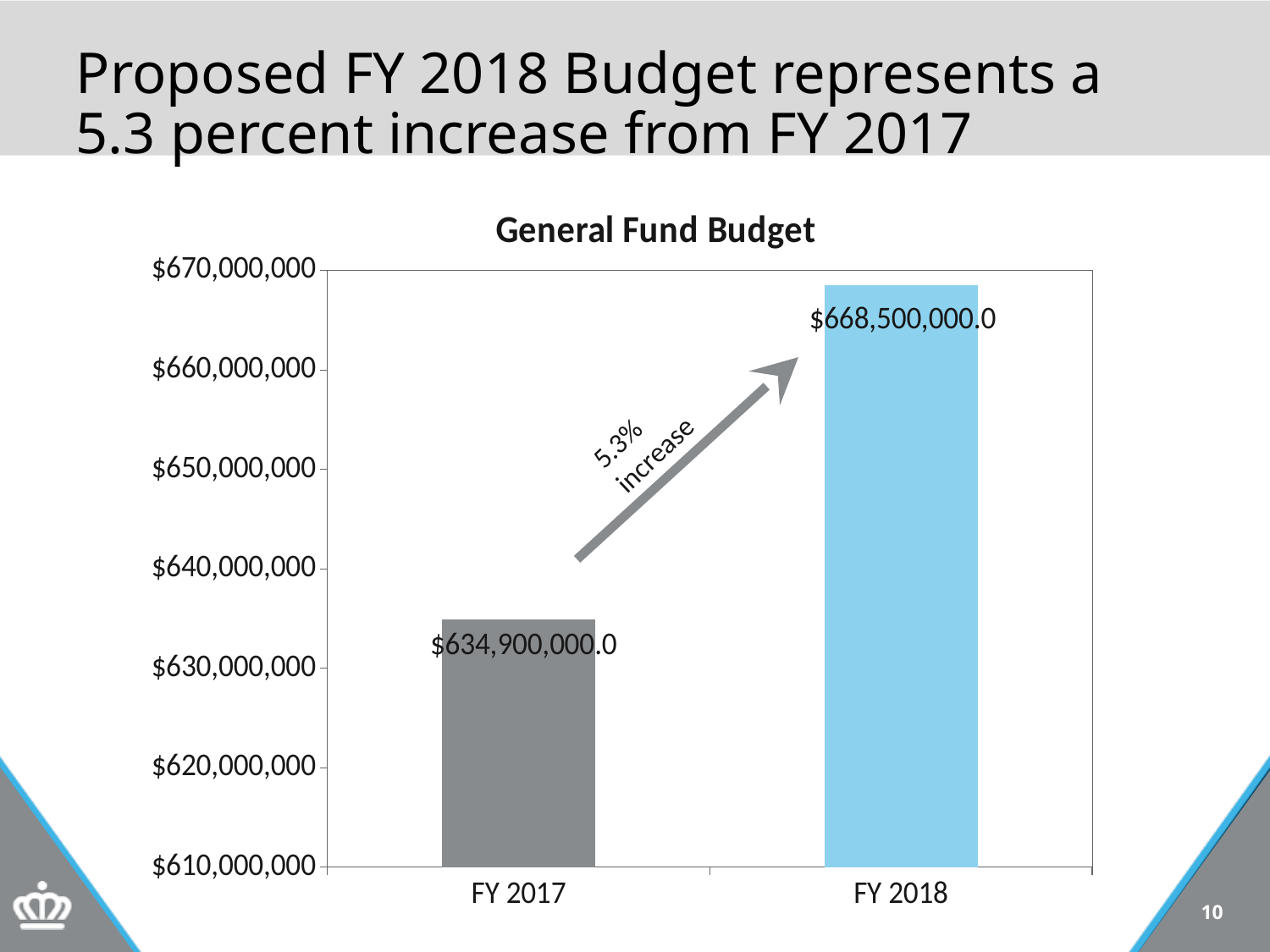
What is the General Fund Budget value for FY 2017? $634,900,000.0 What is the General Fund Budget value for FY 2018? $668,500,000.0 Is the General Fund Budget larger in FY 2017 or FY 2018? FY 2018 Which fiscal year has the higher General Fund Budget? FY 2018 What is the difference between the FY 2018 and FY 2017 General Fund Budget values? $33,600,000.0 Which fiscal year has the lower General Fund Budget? FY 2017 Is the value for FY 2017 greater or less than $640,000,000? less What kind of chart is shown on the slide? Bar chart Does the General Fund Budget rise or fall from FY 2017 to FY 2018? Rise What is the title of the chart? General Fund Budget How many fiscal years are shown on the chart? 2 Is the value for FY 2018 greater or less than $660,000,000? greater